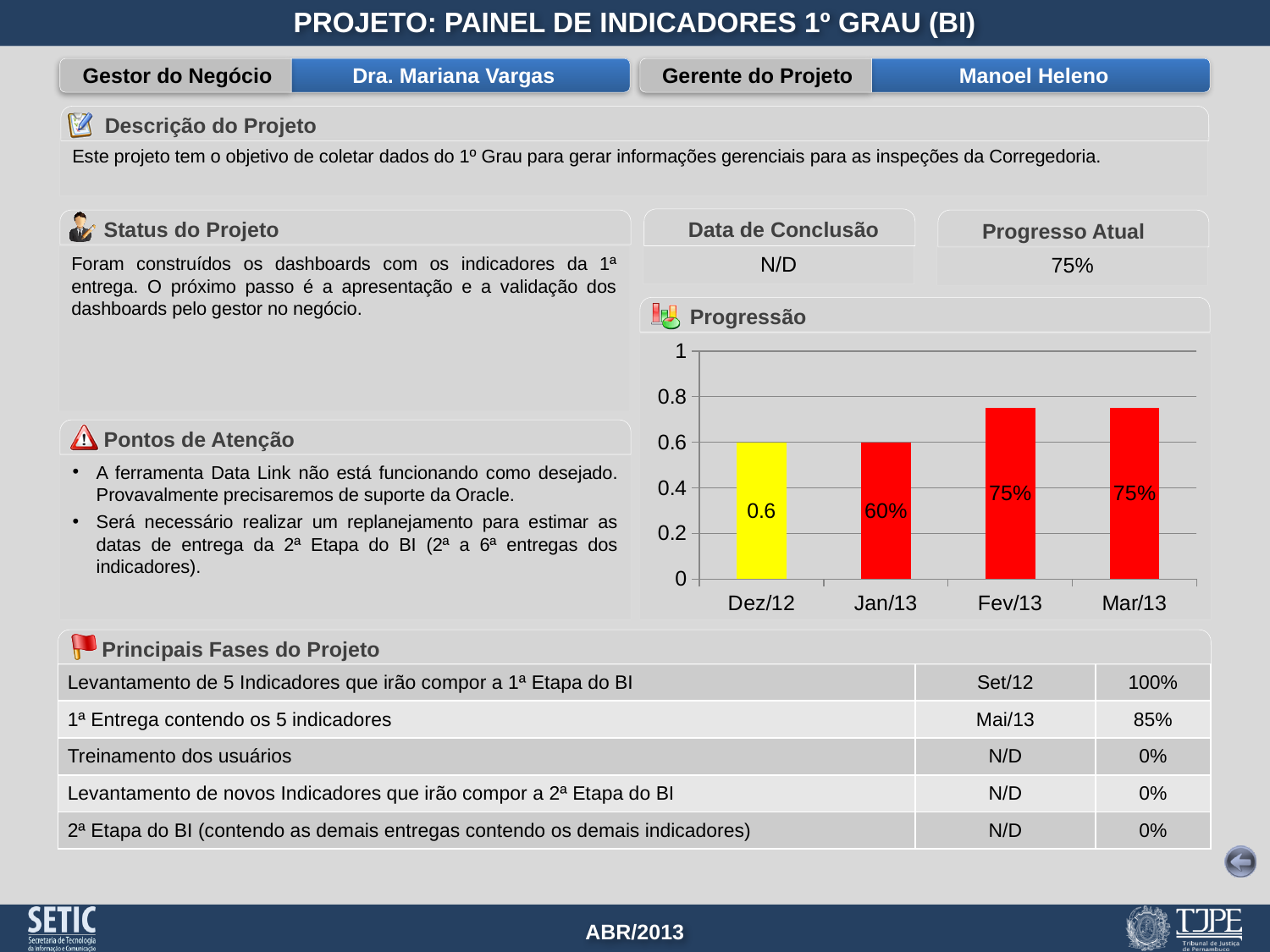
What is the value shown for Mar/13 in the Progressão chart? 75% What kind of chart is the Progressão chart? bar chart What is the value shown for Fev/13 in the Progressão chart? 75% Is the value for Dez/12 in the Progressão chart greater or less than 0.8? less What colour is the bar for Dez/12 in the Progressão chart? yellow What is the value shown for Dez/12 in the Progressão chart? 0.6 What is the value shown for Jan/13 in the Progressão chart? 60% Is the value for Fev/13 in the Progressão chart greater or less than 0.6? greater What is the title of the chart on the slide? Progressão How many categories are plotted on the x axis of the Progressão chart? 4 Which is larger in the Progressão chart, the value for Jan/13 or the value for Fev/13? Fev/13 Do the values in the Progressão chart rise or fall from Jan/13 to Fev/13? rise